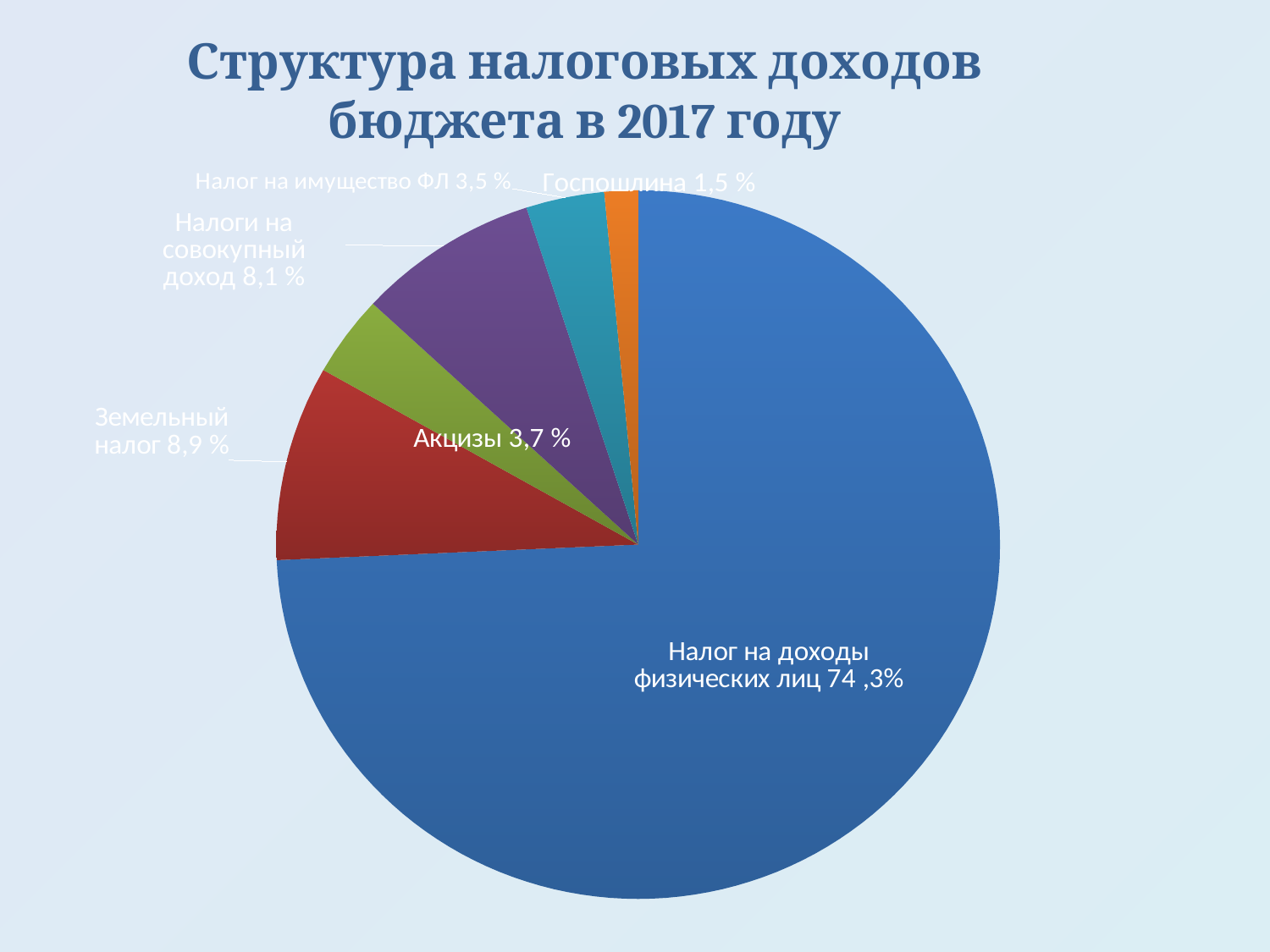
What kind of chart is shown on the slide? Pie chart What is the value shown for Акцизы? 3,7 % What is the value shown for Налоги на совокупный доход? 8,1 % What share of tax revenues does Налог на доходы физических лиц account for? 74,3% What is the value shown for Госпошлина? 1,5 % Which is larger, Акцизы or Налог на имущество ФЛ? Акцизы Which category has the smallest slice of the pie? Госпошлина Which category has the largest slice of the pie? Налог на доходы физических лиц What is the value shown for Земельный налог? 8,9 % What is the title of the chart? Структура налоговых доходов бюджета в 2017 году What is the difference between Земельный налог and Налоги на совокупный доход? 0,8 % How many categories are shown in the pie chart? 6